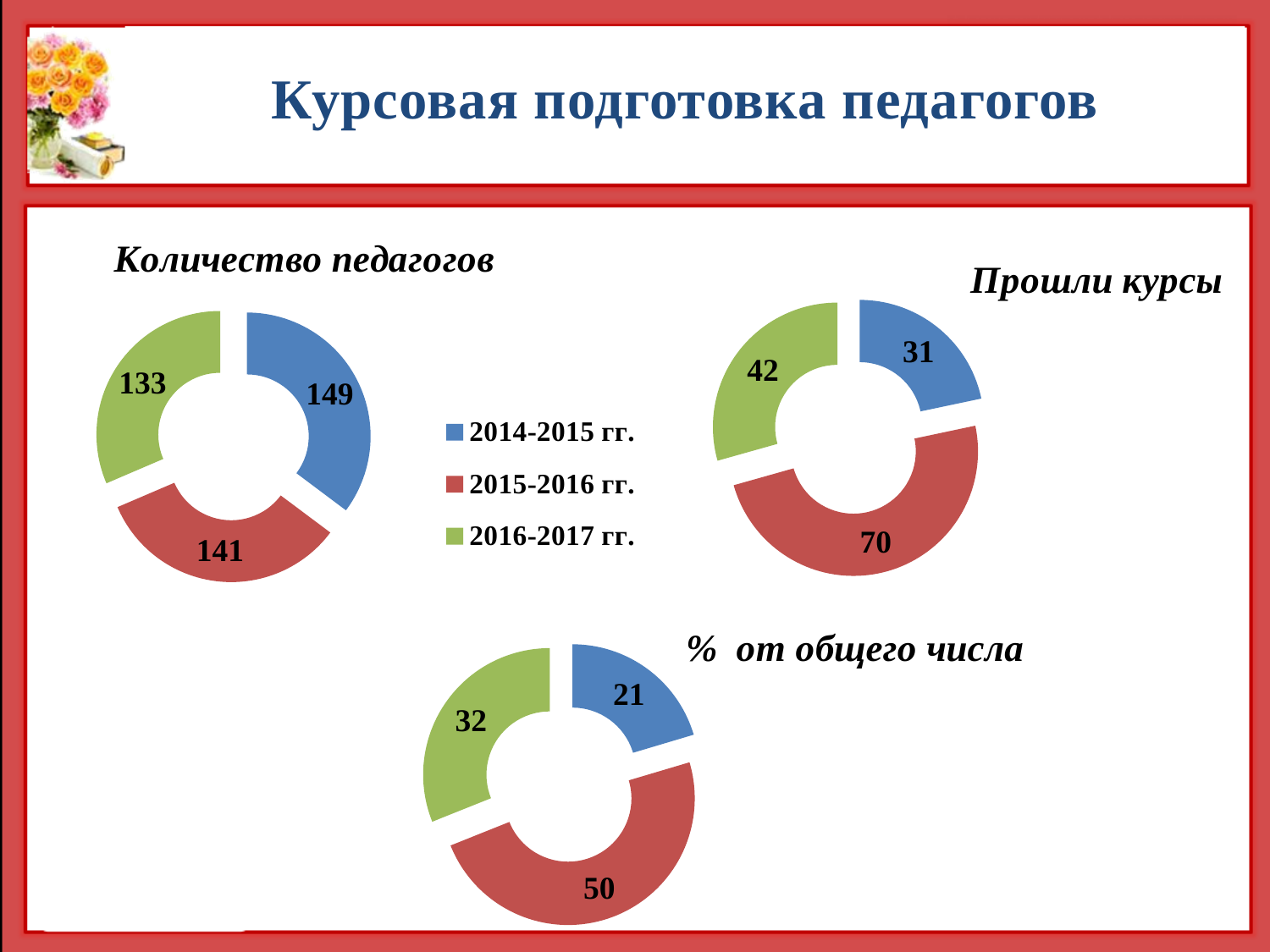
In the chart titled "Количество педагогов", what is the value for 2014-2015 гг.? 149 What kind of chart is the chart titled "% от общего числа"? Doughnut (pie) chart In the chart titled "% от общего числа", which year has the lowest value? 2014-2015 гг. In the chart titled "Количество педагогов", what is the difference between the values for 2014-2015 гг. and 2015-2016 гг.? 8 In the chart titled "Количество педагогов", what is the value for 2016-2017 гг.? 133 In the chart titled "% от общего числа", what is the value for 2016-2017 гг.? 32 In the chart titled "Количество педагогов", which year has the lowest value? 2016-2017 гг. How many charts are shown on the slide? 3 In the chart titled "Прошли курсы", what is the value for 2015-2016 гг.? 70 In the chart titled "Прошли курсы", which is larger: the value for 2016-2017 гг. or the value for 2014-2015 гг.? 2016-2017 гг. In the chart titled "Прошли курсы", what is the difference between the values for 2015-2016 гг. and 2014-2015 гг.? 39 In the chart titled "Прошли курсы", which year has the highest value? 2015-2016 гг.